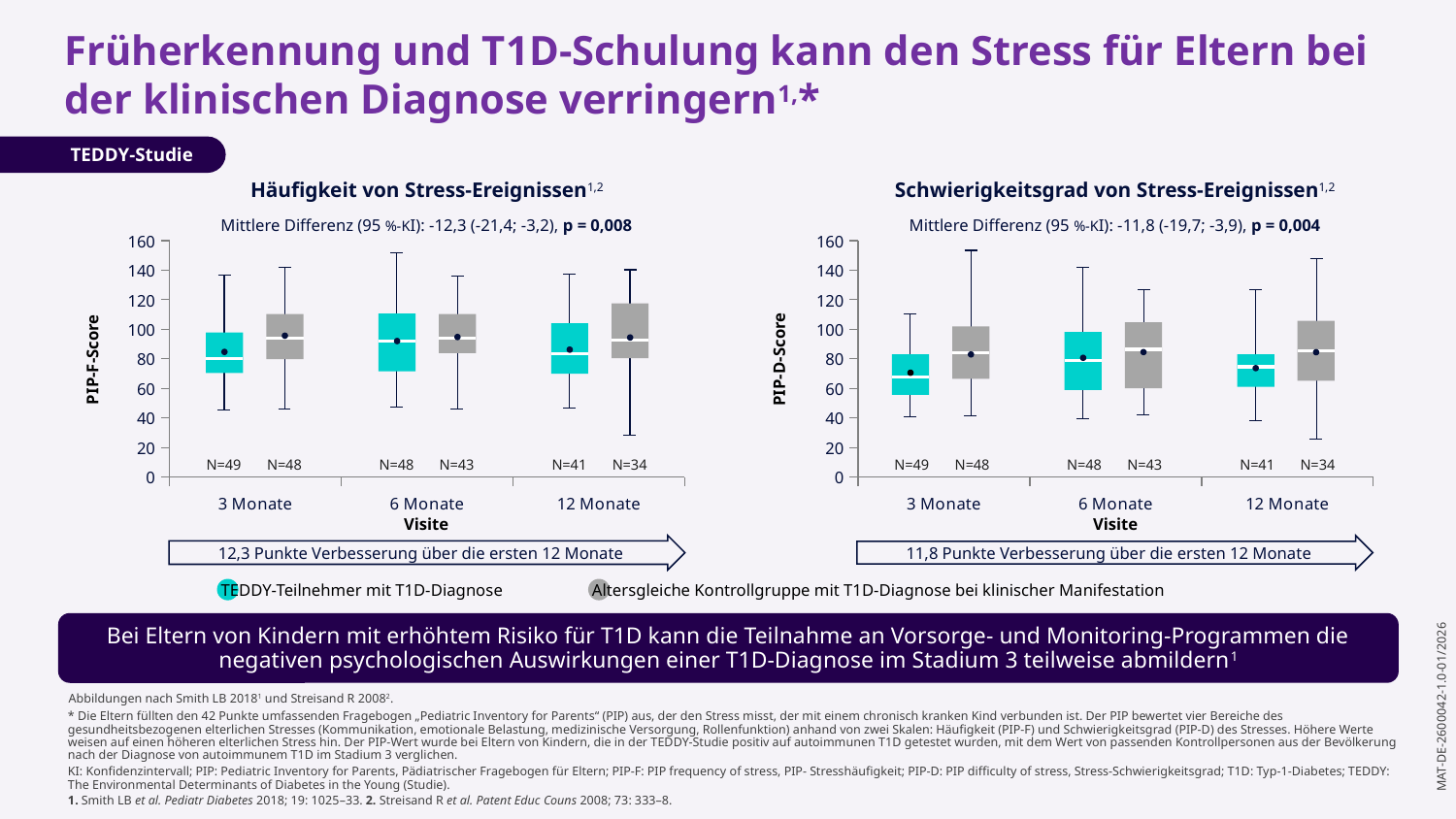
What improvement over the first 12 months is stated in the arrow below the 'Häufigkeit von Stress-Ereignissen' chart? 12,3 Punkte Verbesserung über die ersten 12 Monate In the 'Häufigkeit von Stress-Ereignissen' chart, what is the N for the TEDDY participants at the 3 Monate visit? N=49 In the 'Schwierigkeitsgrad von Stress-Ereignissen' chart at the 12 Monate visit, which group has the higher median PIP-D-Score: the TEDDY participants or the control group? Control group (Altersgleiche Kontrollgruppe) In the 'Schwierigkeitsgrad von Stress-Ereignissen' chart, is the median PIP-D-Score for the TEDDY participants at 3 Monate greater or less than 100? less In the 'Schwierigkeitsgrad von Stress-Ereignissen' chart, what is the N for the control group at the 6 Monate visit? N=43 How many visit time points are shown on the x axis of the 'Häufigkeit von Stress-Ereignissen' chart? 3 What p-value is reported above the 'Häufigkeit von Stress-Ereignissen' chart? p = 0,008 What type of chart is used in the 'Häufigkeit von Stress-Ereignissen' chart? Box plot What mean difference (Mittlere Differenz) is reported above the 'Schwierigkeitsgrad von Stress-Ereignissen' chart? -11,8 (-19,7; -3,9) What is the y-axis label of the 'Schwierigkeitsgrad von Stress-Ereignissen' chart? PIP-D-Score How many groups does the legend below the charts list? 2 In the 'Häufigkeit von Stress-Ereignissen' chart, what is the N for the control group at the 12 Monate visit? N=34